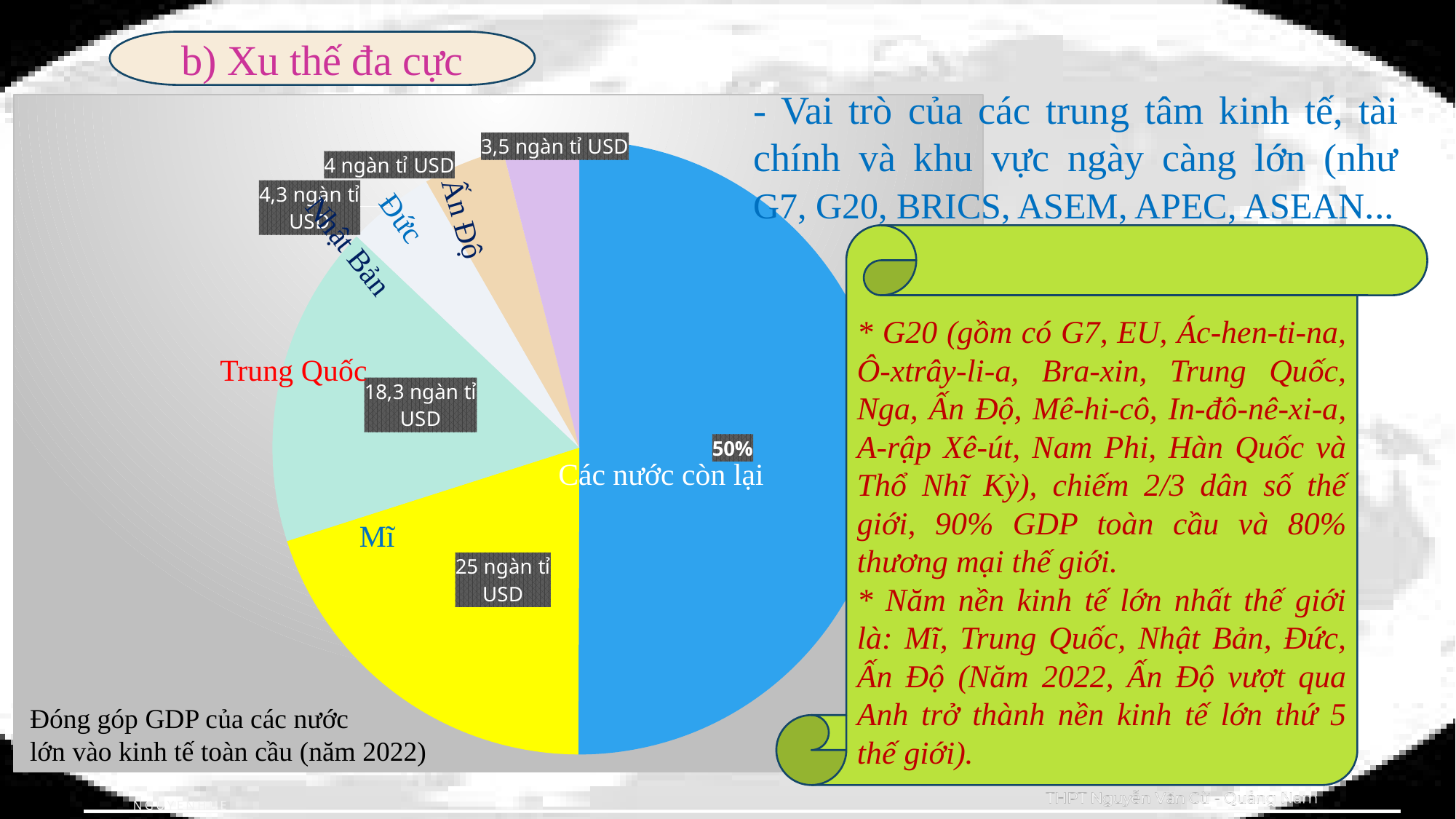
What value is shown for Ấn Độ? 3,5 ngàn tỉ USD What value is shown for Mĩ? 25 ngàn tỉ USD Which slice is the largest in the pie chart? Các nước còn lại What kind of chart is shown on the slide? Pie chart What is the title of the chart? Đóng góp GDP của các nước lớn vào kinh tế toàn cầu (năm 2022) Which of the named countries has the smallest value? Ấn Độ Which is larger, the value for Mĩ or the value for Trung Quốc? Mĩ What is the difference between the values for Mĩ and Trung Quốc? 6,7 ngàn tỉ USD How many slices does the pie chart have? 6 What value is shown for Nhật Bản? 4,3 ngàn tỉ USD What value is shown for Trung Quốc? 18,3 ngàn tỉ USD What share of the pie is labelled for Các nước còn lại? 50%